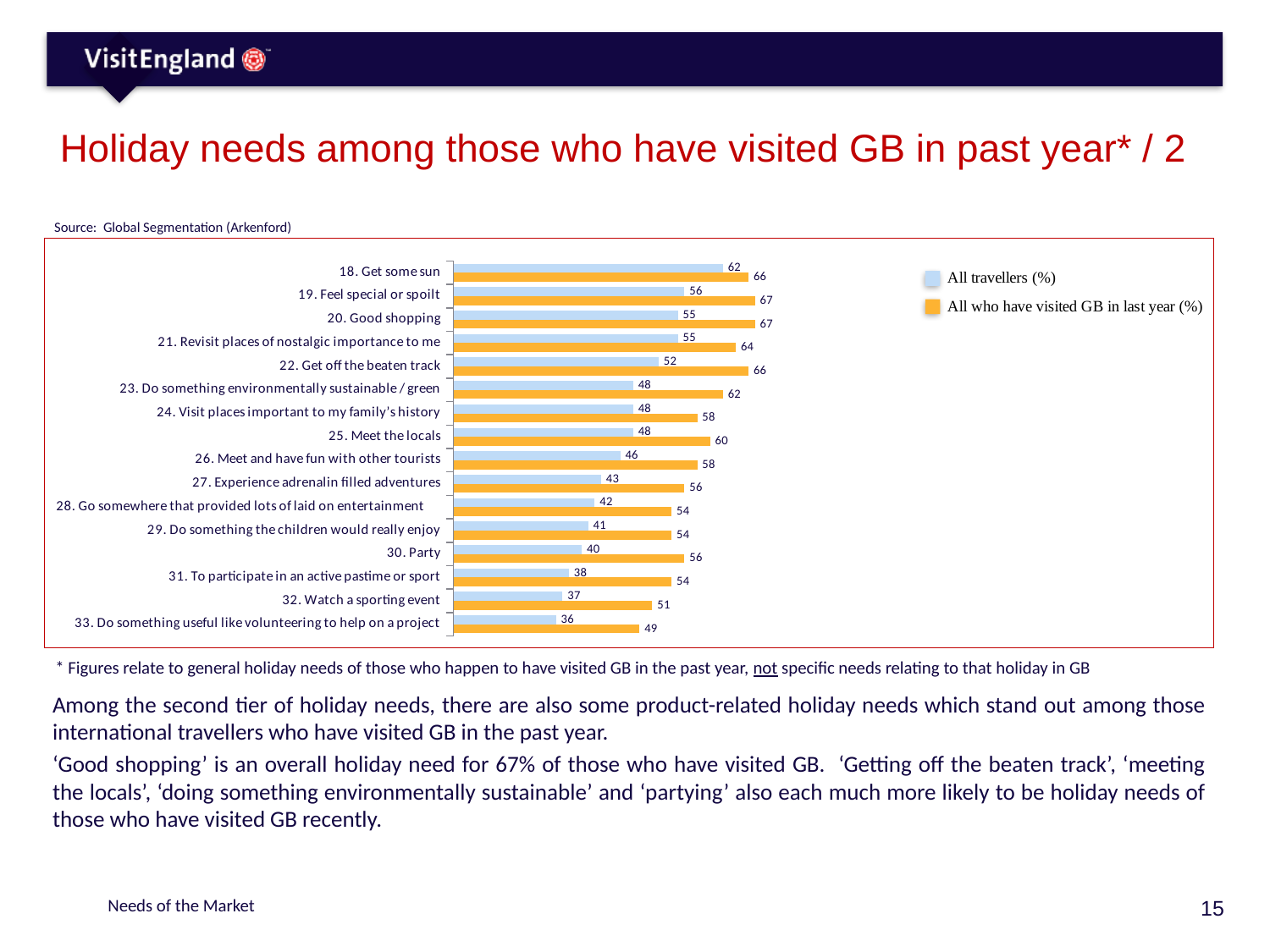
What is the value for 'All who have visited GB in last year (%)' for '20. Good shopping'? 67 Which is larger for '25. Meet the locals': the 'All travellers (%)' value or the 'All who have visited GB in last year (%)' value? All who have visited GB in last year (%) How many holiday needs (categories) are plotted on the chart? 16 Do the 'All travellers (%)' values rise or fall going down the list from '18. Get some sun' to '33. Do something useful like volunteering to help on a project'? fall What kind of chart is shown on the slide? bar chart What is the value for 'All who have visited GB in last year (%)' for '30. Party'? 56 What is the difference between the 'All who have visited GB in last year (%)' value and the 'All travellers (%)' value for '23. Do something environmentally sustainable / green'? 14 Which colour represents the 'All who have visited GB in last year (%)' series in the chart? orange Which category has the highest value for 'All travellers (%)'? 18. Get some sun What is the value for 'All travellers (%)' for '22. Get off the beaten track'? 52 Which category has the lowest value for 'All who have visited GB in last year (%)'? 33. Do something useful like volunteering to help on a project How many series does the chart legend list? 2